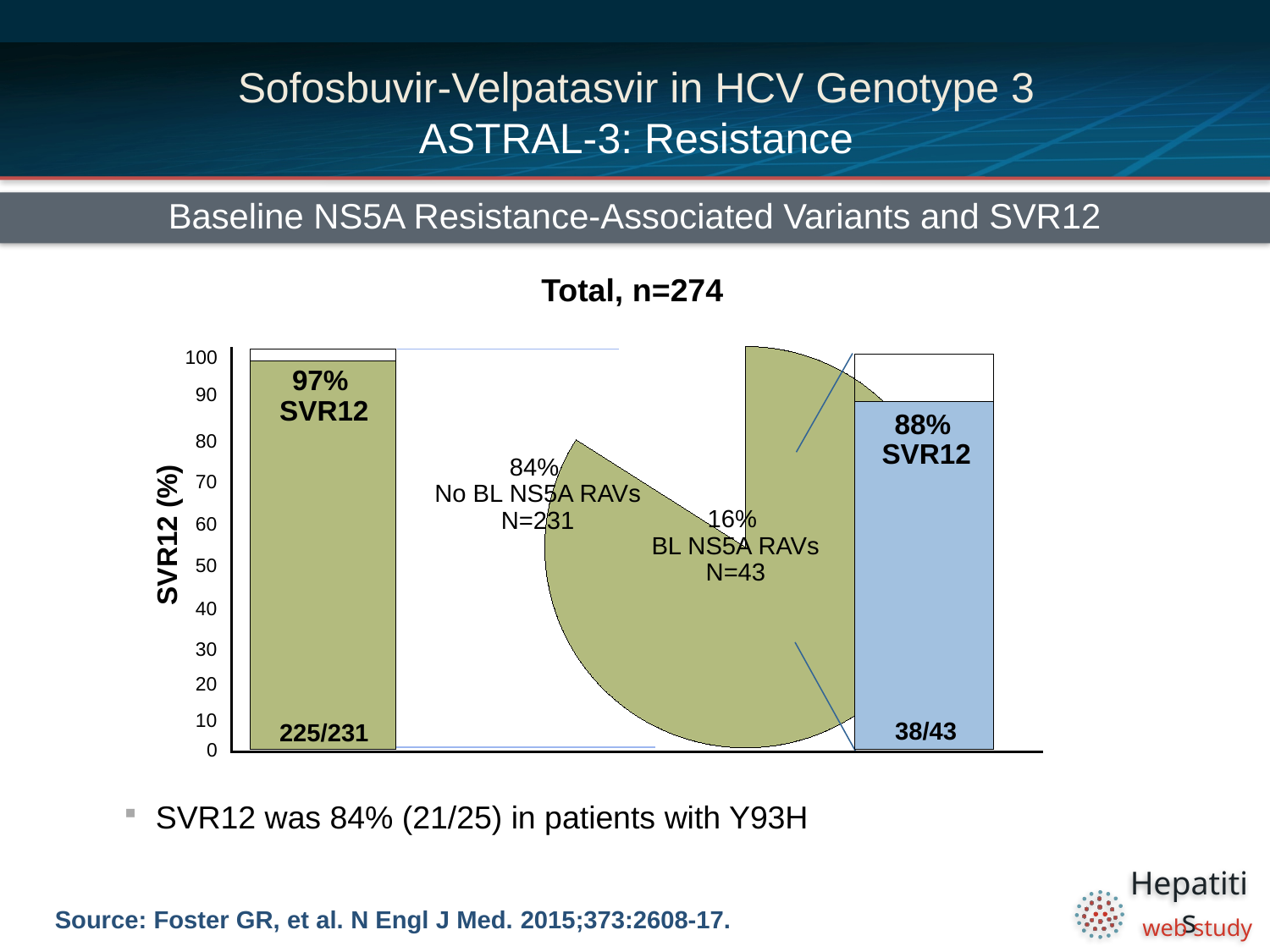
In the SVR12 bar chart, what is the SVR12 rate for patients with no baseline NS5A RAVs? 97% In the SVR12 bar chart, which group has the higher SVR12 rate: no baseline NS5A RAVs or baseline NS5A RAVs? No BL NS5A RAVs In the pie chart titled "Total, n=274", how many patients are in the "No BL NS5A RAVs" slice? N=231 In the pie chart titled "Total, n=274", what share of patients had no baseline NS5A RAVs? 84% In the SVR12 bar chart, what fraction of patients with baseline NS5A RAVs achieved SVR12? 38/43 In the pie chart titled "Total, n=274", how many slices are shown? 2 What is the label of the y axis on the SVR12 bar chart? SVR12 (%) In the pie chart titled "Total, n=274", what share of patients had baseline NS5A RAVs? 16% In the SVR12 bar chart, what is the SVR12 rate for patients with baseline NS5A RAVs? 88% In the SVR12 bar chart, what fraction of patients with no baseline NS5A RAVs achieved SVR12? 225/231 In the SVR12 bar chart, what is the difference in SVR12 rate between the no baseline NS5A RAVs group and the baseline NS5A RAVs group? 9% In the pie chart titled "Total, n=274", how many patients are in the "BL NS5A RAVs" slice? N=43